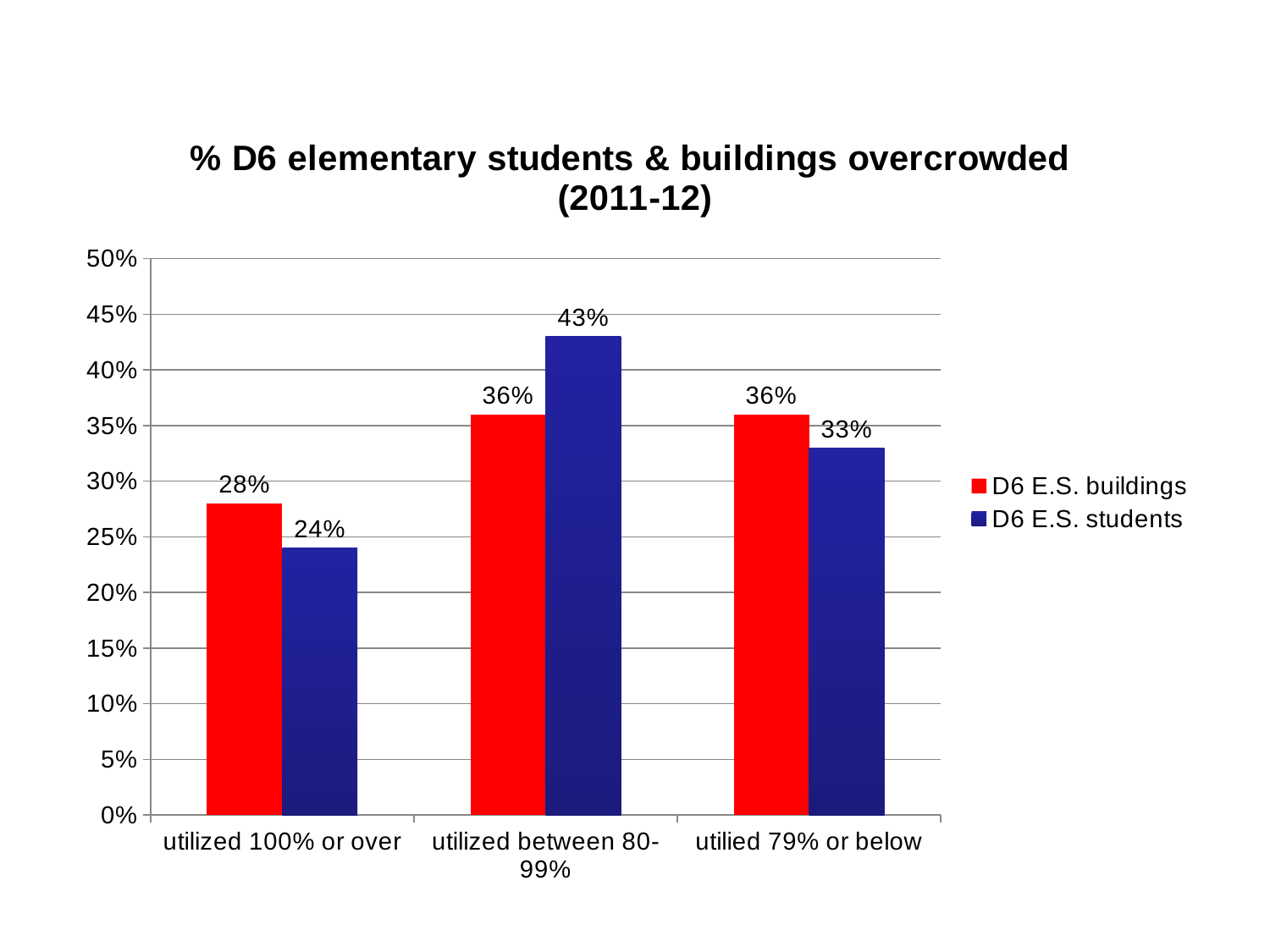
Which category has the highest value for D6 E.S. students? utilized between 80-99% How many series does the legend list? 2 Is the value for D6 E.S. students in the 'utilized 100% or over' category greater or less than 25%? less What kind of chart is shown on the slide? bar chart How many categories are shown on the x axis? 3 In the 'utilied 79% or below' category, which series has the larger value, D6 E.S. buildings or D6 E.S. students? D6 E.S. buildings What colour represents D6 E.S. students in the chart? blue What is the value for D6 E.S. buildings in the 'utilized 100% or over' category? 28% Which category has the lowest value for D6 E.S. buildings? utilized 100% or over What is the value for D6 E.S. students in the 'utilied 79% or below' category? 33% What is the value for D6 E.S. students in the 'utilized between 80-99%' category? 43% What is the difference between the D6 E.S. students and D6 E.S. buildings values in the 'utilized between 80-99%' category? 7%